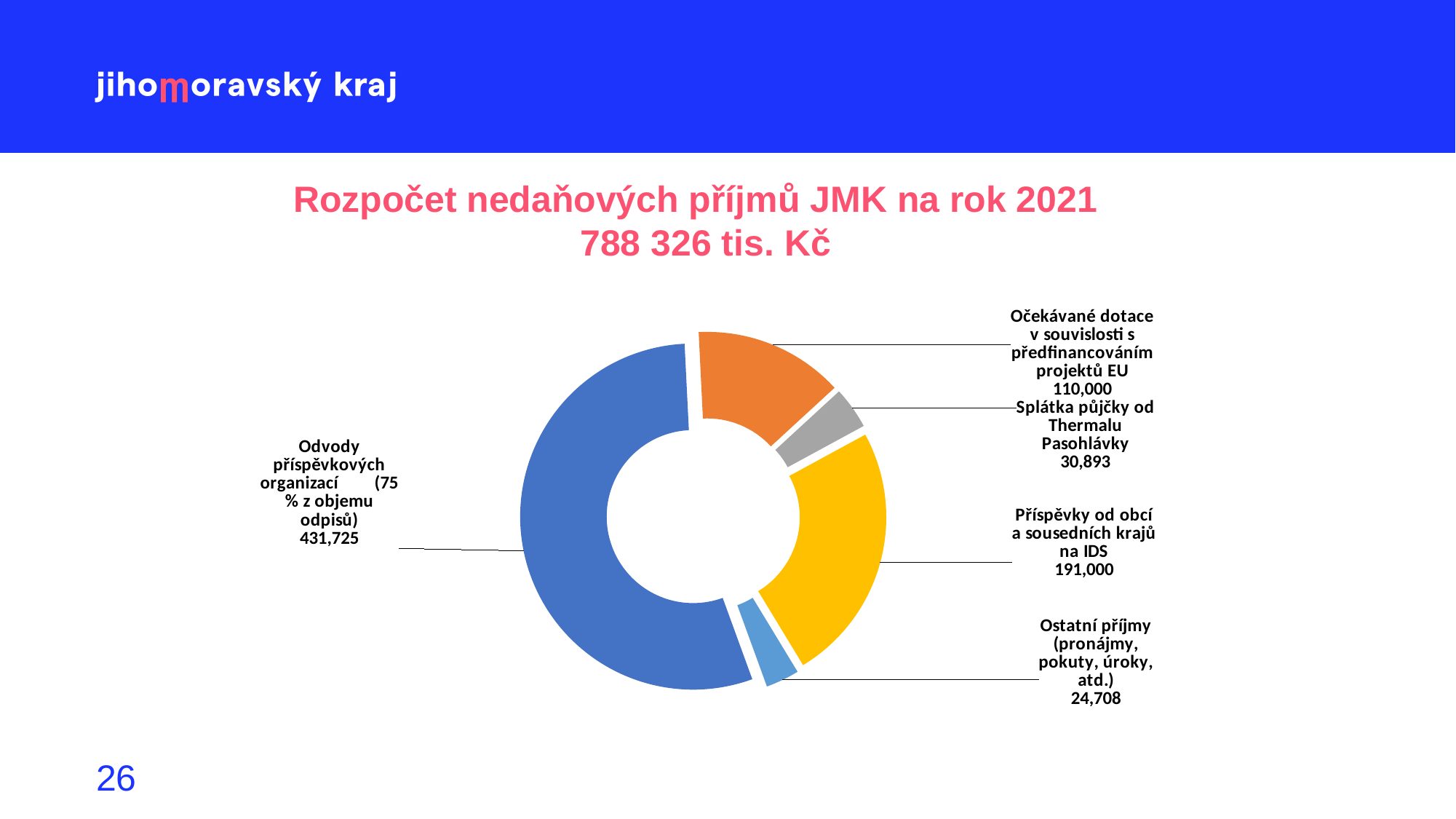
What is the value for Odvody příspěvkových organizací (75 % z objemu odpisů)? 431,725 Which category has the highest value? Odvody příspěvkových organizací (75 % z objemu odpisů) What is the title of the chart? Rozpočet nedaňových příjmů JMK na rok 2021 788 326 tis. Kč How many categories are shown in the chart? 5 What is the value for Splátka půjčky od Thermalu Pasohlávky? 30,893 What is the value for Ostatní příjmy (pronájmy, pokuty, úroky, atd.)? 24,708 What is the value for Příspěvky od obcí a sousedních krajů na IDS? 191,000 What kind of chart is shown on the slide? Doughnut chart What is the difference between Očekávané dotace v souvislosti s předfinancováním projektů EU and Splátka půjčky od Thermalu Pasohlávky? 79,107 Which is larger: Očekávané dotace v souvislosti s předfinancováním projektů EU or Příspěvky od obcí a sousedních krajů na IDS? Příspěvky od obcí a sousedních krajů na IDS What is the difference between Odvody příspěvkových organizací and Příspěvky od obcí a sousedních krajů na IDS? 240,725 Which category has the lowest value? Ostatní příjmy (pronájmy, pokuty, úroky, atd.)